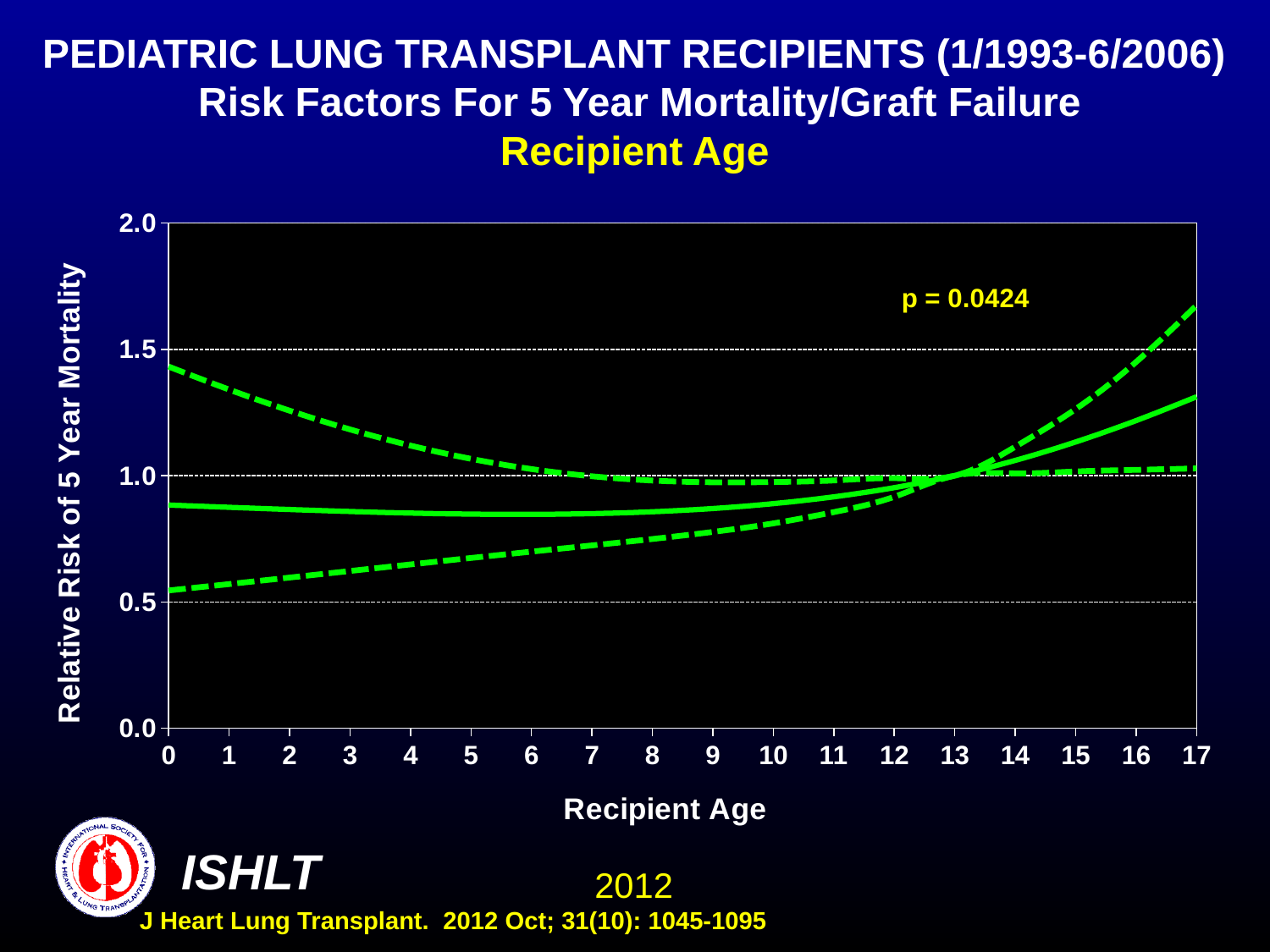
Is the value of the solid line at recipient age 0 greater or less than 1.0? less Does the solid line rise or fall between recipient age 13 and recipient age 17? rise Is the value of the solid line at recipient age 17 greater or less than 1.5? less What is the label of the y axis? Relative Risk of 5 Year Mortality How many recipient age values are labelled on the x axis? 18 Is the value of the upper dashed line at recipient age 17 greater or less than 1.5? greater What kind of chart is shown on the slide? line chart Does the lower dashed line rise or fall from recipient age 0 to recipient age 17? rise What p-value is printed on the chart? p = 0.0424 Does the upper dashed line rise or fall between recipient age 0 and recipient age 7? fall